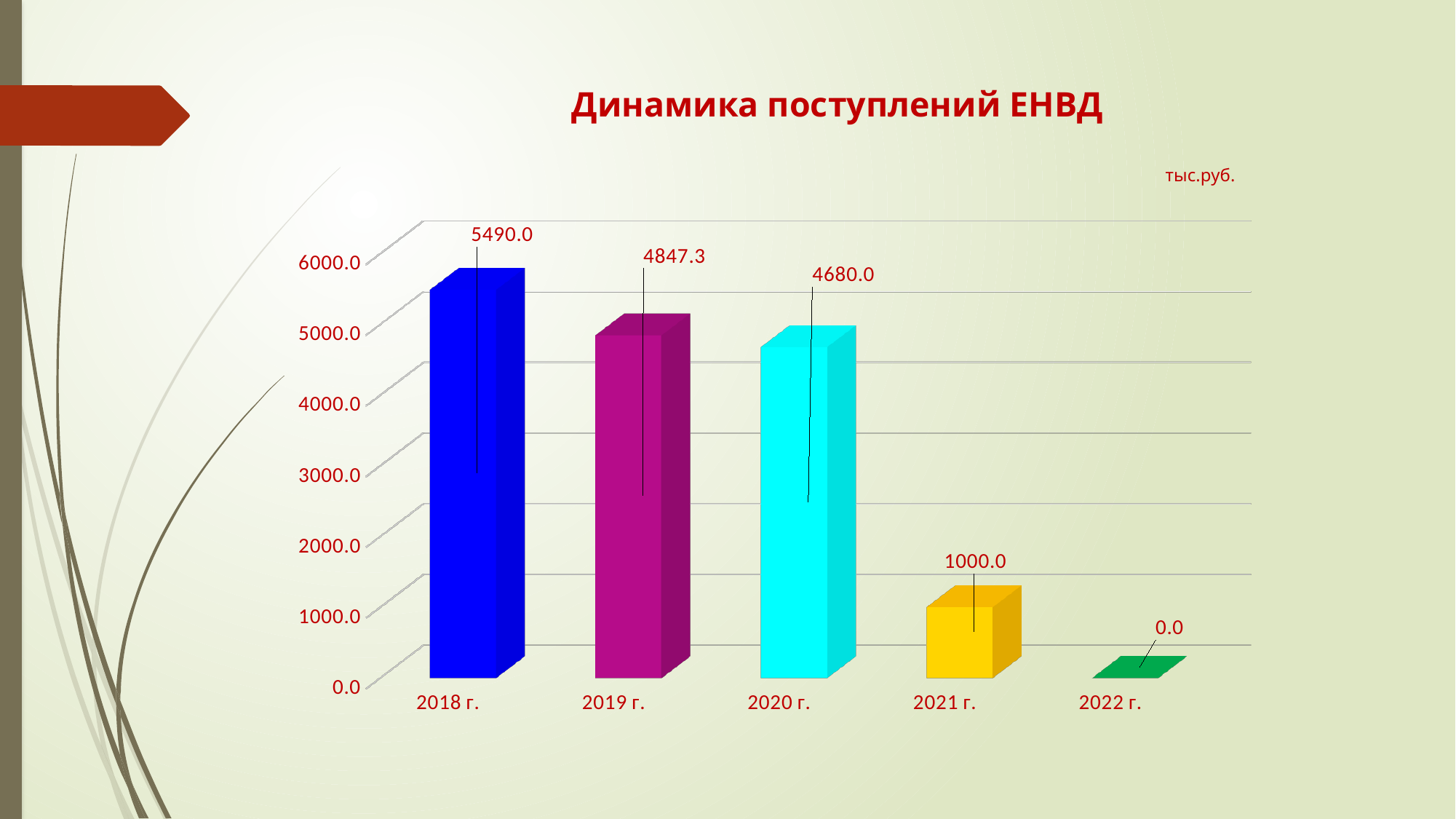
What is the value for 2019 г.? 4847.3 What kind of chart is shown on the slide? Bar chart Which year has the highest value? 2018 г. What is the difference between the values for 2018 г. and 2019 г.? 642.7 How many years are shown on the x axis? 5 What is the value for 2018 г.? 5490.0 What is the value for 2022 г.? 0.0 Which year has the lowest value? 2022 г. What is the value for 2020 г.? 4680.0 What is the value for 2021 г.? 1000.0 Which is larger, the value for 2020 г. or the value for 2021 г.? 2020 г. Do the values rise or fall from 2018 г. to 2022 г.? Fall